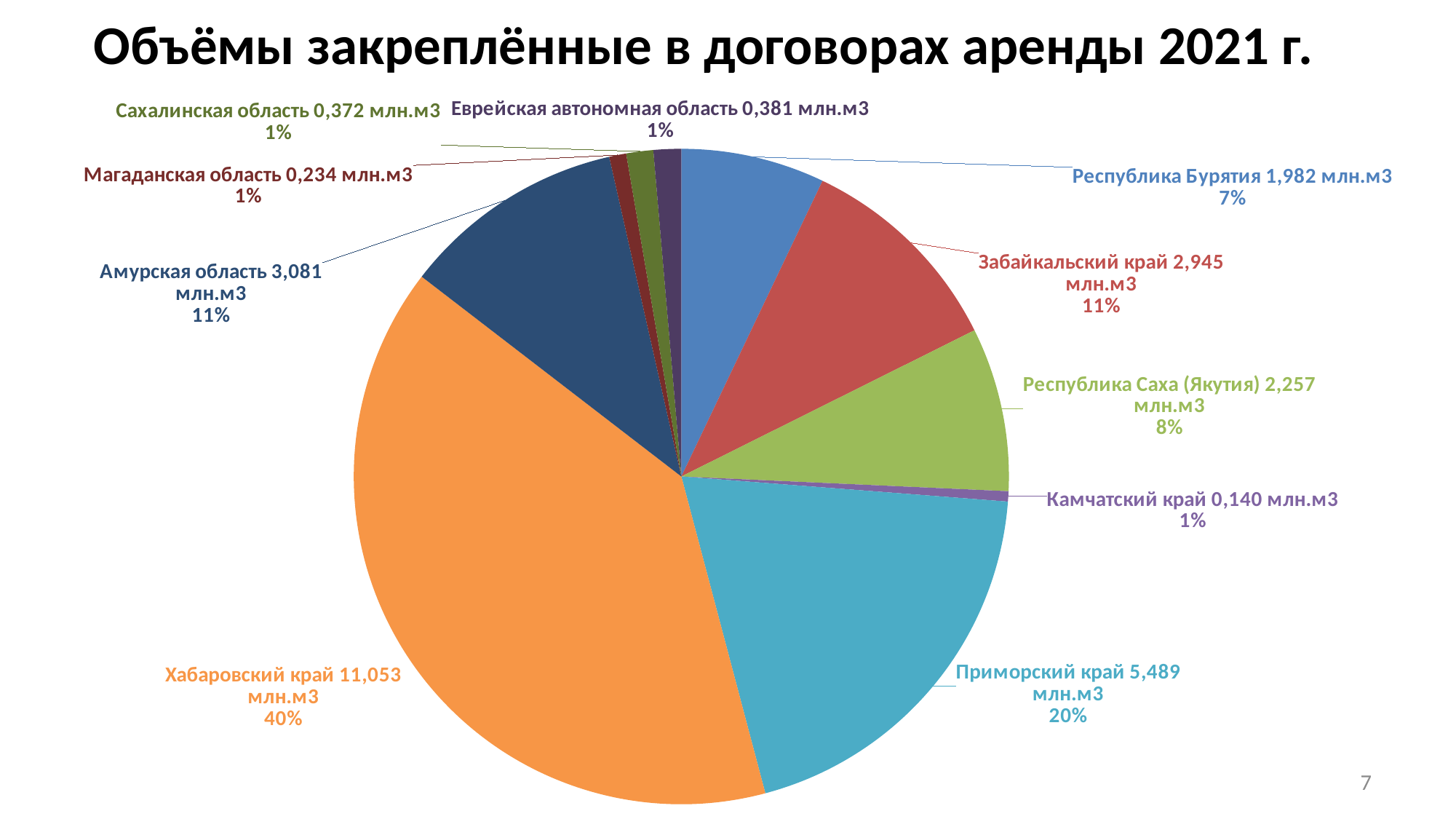
What share of the pie does Республика Бурятия represent? 7% How many regions (slices) are shown in the pie chart? 10 Which region has the largest volume? Хабаровский край What type of chart is shown on the slide? pie chart What is the volume for Еврейская автономная область? 0,381 млн.м3 Which region has the smallest volume? Камчатский край Which has a larger volume, Приморский край or Амурская область? Приморский край What is the difference in volume between Хабаровский край and Приморский край? 5,564 млн.м3 What is the title of the chart? Объёмы закреплённые в договорах аренды 2021 г. What is the volume for Приморский край? 5,489 млн.м3 What share of the pie does Хабаровский край represent? 40% What is the volume for Республика Саха (Якутия)? 2,257 млн.м3